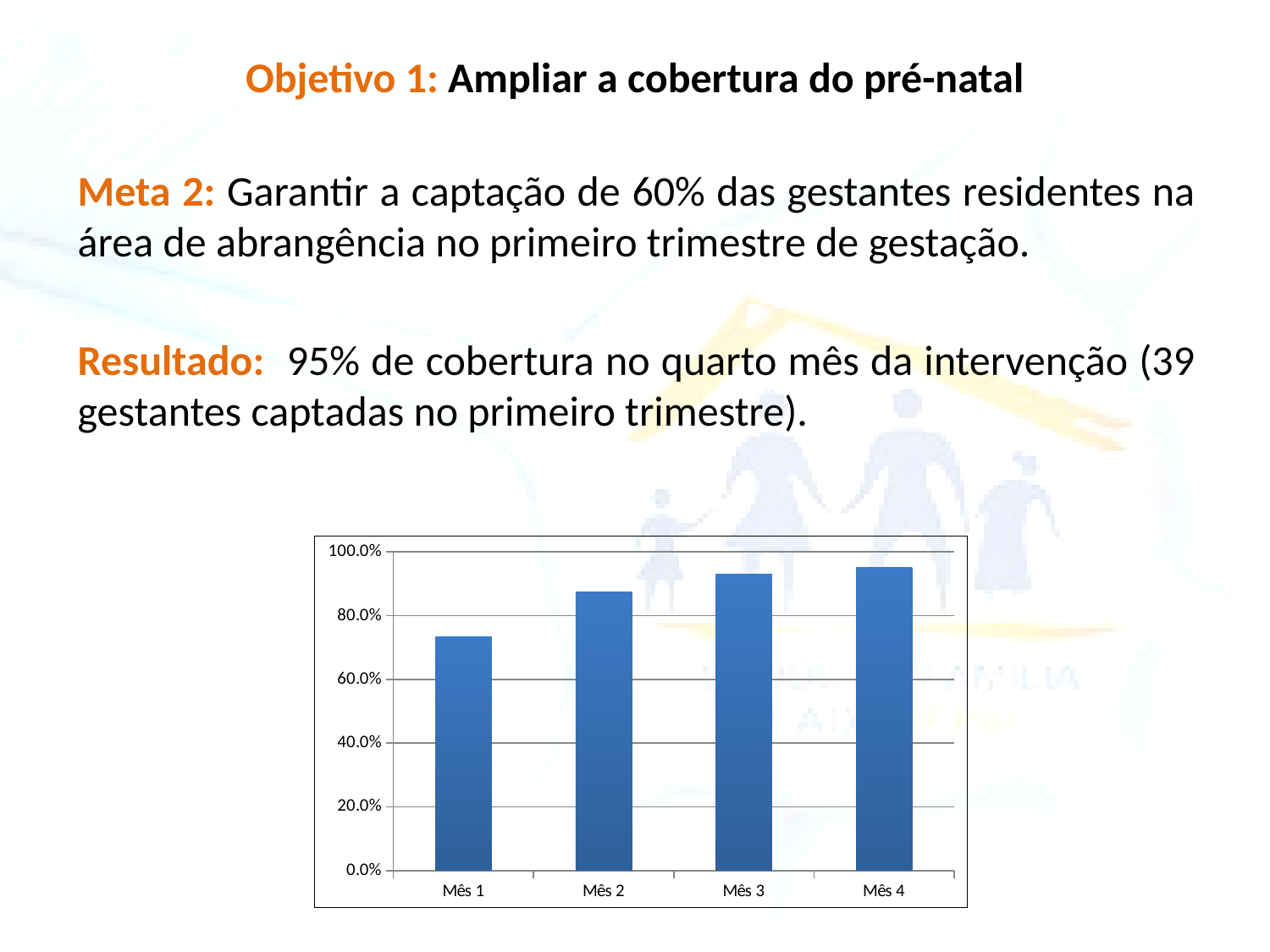
How many categories (months) are plotted on the chart? 4 Which month has the lowest bar on the chart? Mês 1 Is the value for Mês 3 greater or less than 80%? greater Which is larger, the value for Mês 1 or the value for Mês 3? Mês 3 Is the value for Mês 1 greater or less than 80%? less Is the value for Mês 4 greater or less than 100%? less What kind of chart is shown on the slide? bar chart Which is larger, the value for Mês 1 or the value for Mês 2? Mês 2 Do the values rise or fall from Mês 1 to Mês 4? rise What is the highest tick value shown on the vertical axis of the chart? 100.0%